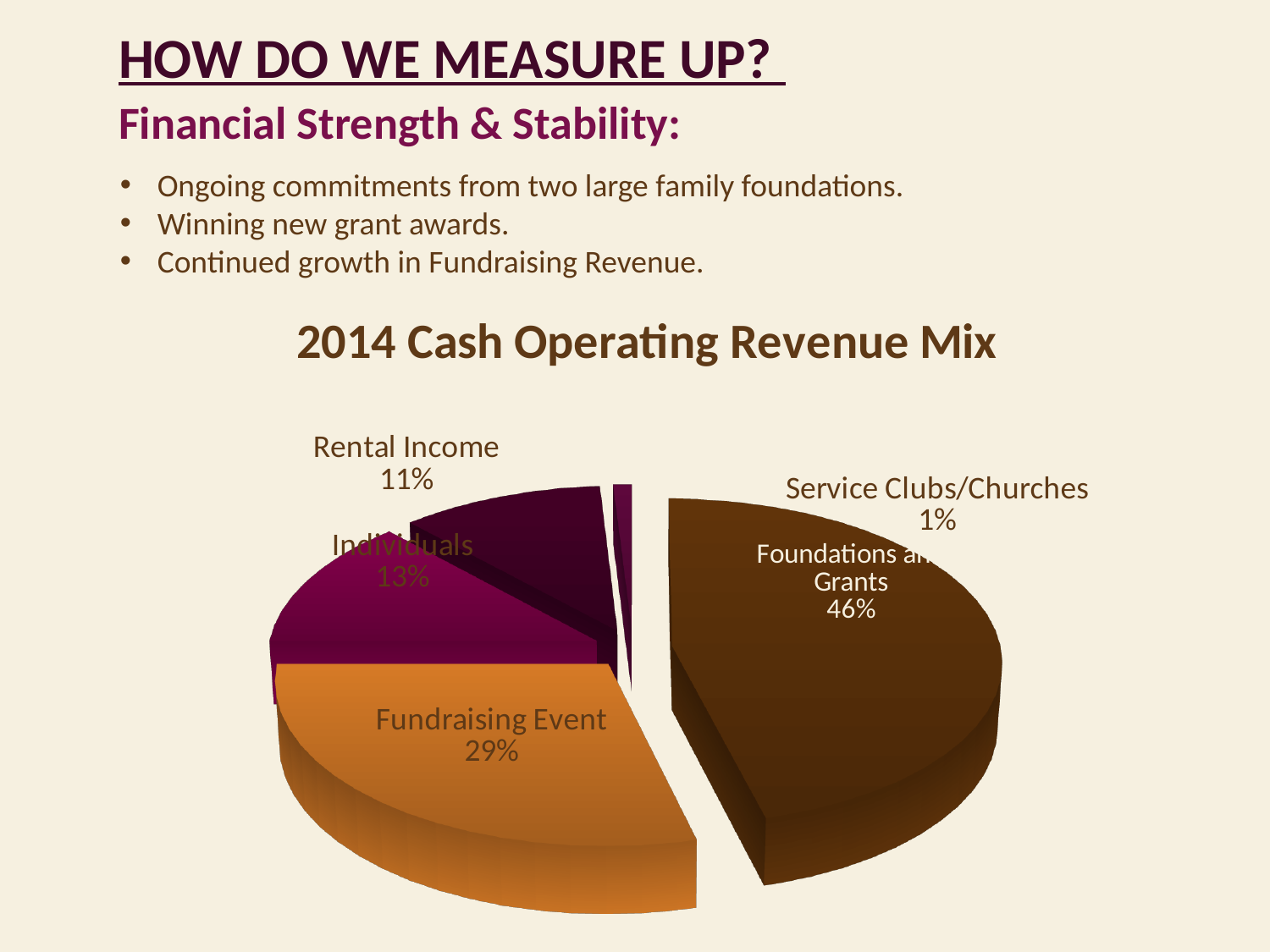
Which category has the largest share of the 2014 Cash Operating Revenue Mix? Foundations and Grants What is the title of the chart? 2014 Cash Operating Revenue Mix What share of the revenue mix is Service Clubs/Churches? 1% What share of the 2014 Cash Operating Revenue Mix comes from Fundraising Event? 29% Which is larger: the share for Individuals or the share for Rental Income? Individuals What is the combined share of Individuals and Rental Income? 24% How many percentage points larger is the Foundations and Grants share than the Fundraising Event share? 17 What type of chart is shown on the slide? pie chart What percentage of the revenue mix comes from Individuals? 13% Which category has the smallest share of the revenue mix? Service Clubs/Churches What percentage of the revenue mix is Rental Income? 11% How many slices does the pie chart have? 5